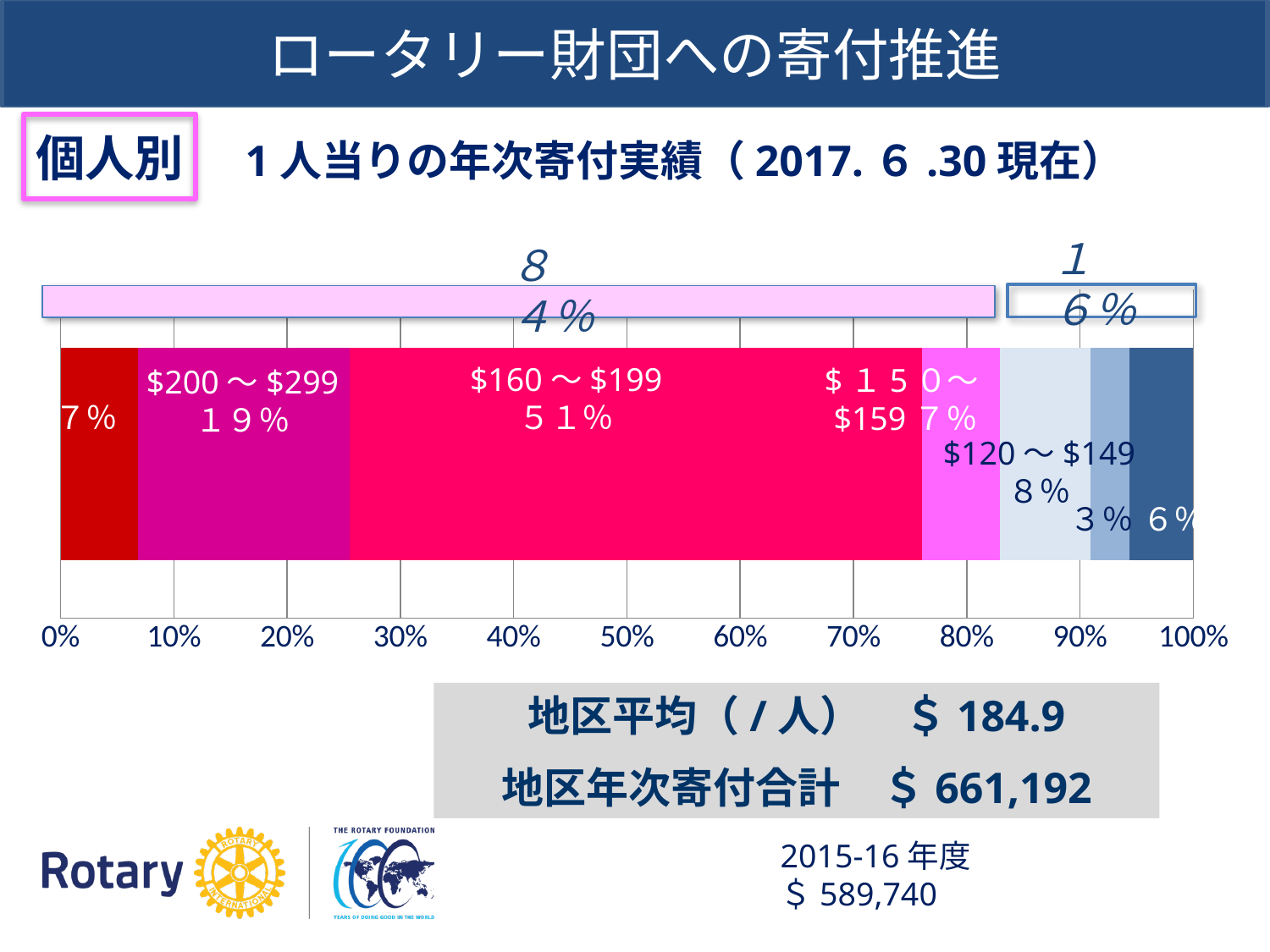
How many percentage points larger is the $160～$199 share than the $200～$299 share? 32% What percentage is shown above the blue bracket at the right end of the bar? 16% How many segments make up the stacked bar? 7 What percentage of members is in the $120～$149 range? 8% What percentage of members is in the $150～$159 range? 7% What percentage of members is in the $200～$299 range? 19% What kind of chart is shown on the slide? Stacked bar chart What is the difference between the $120～$149 share and the $150～$159 share? 1% Which labelled contribution range has the largest share of the bar? $160～$199 Which is larger, the share for $200～$299 or the share for $120～$149? $200～$299 What percentage is shown above the pink bracket spanning the left part of the bar? 84% What percentage of members is in the $160～$199 range? 51%